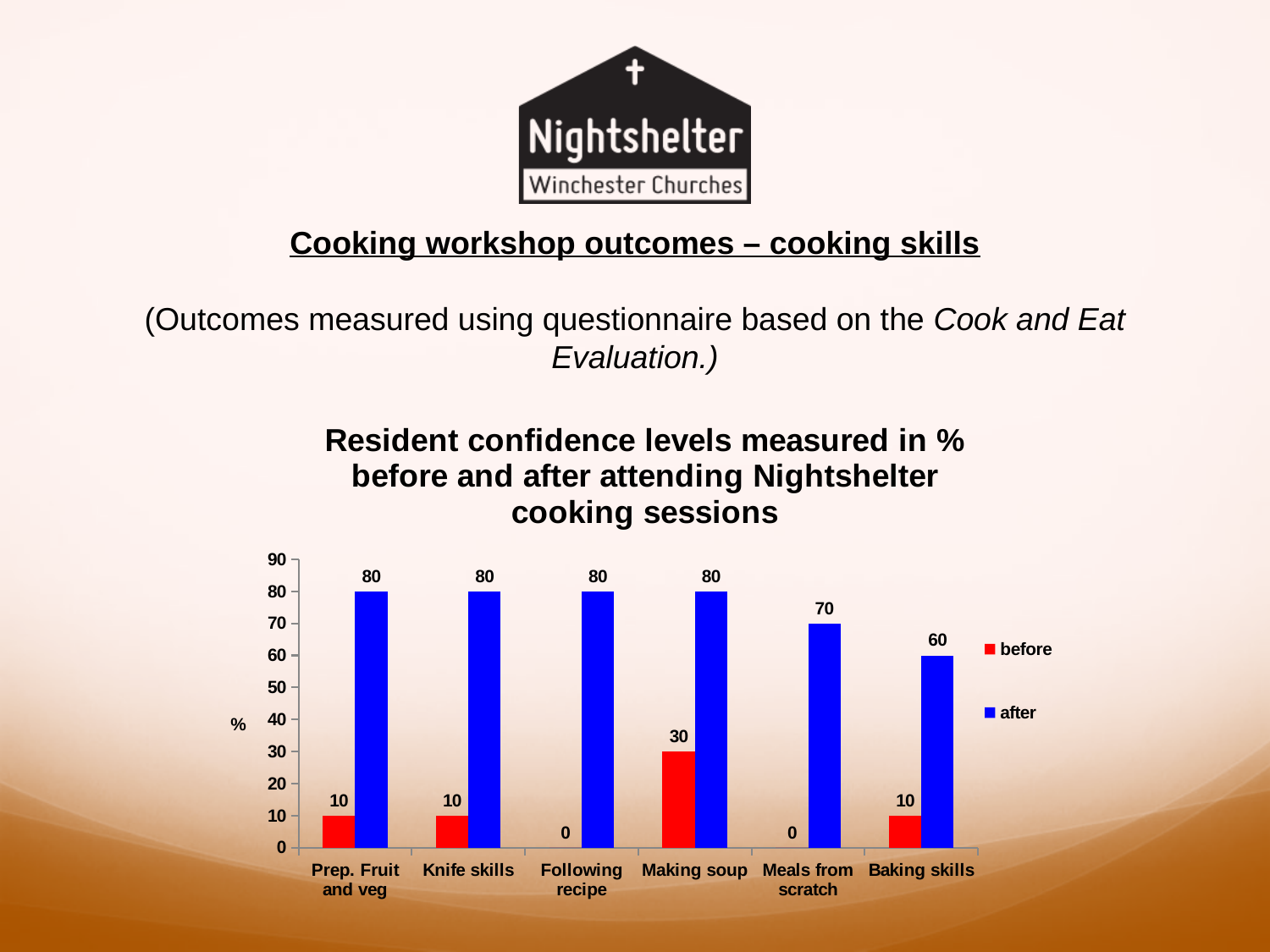
Which category has the highest 'before' value? Making soup Which category has the lowest 'after' value? Baking skills How many categories are shown on the x axis? 6 Which is larger: the 'after' value for Meals from scratch or the 'after' value for Baking skills? Meals from scratch What is the 'before' value for Following recipe? 0 How many series does the legend list? 2 What is the 'after' value for Making soup? 80 What is the 'before' value for Making soup? 30 What kind of chart is shown on the slide? Bar chart What is the 'after' value for Baking skills? 60 What is the difference between the 'after' and 'before' values for Meals from scratch? 70 Which colour represents the 'after' series in the chart? Blue